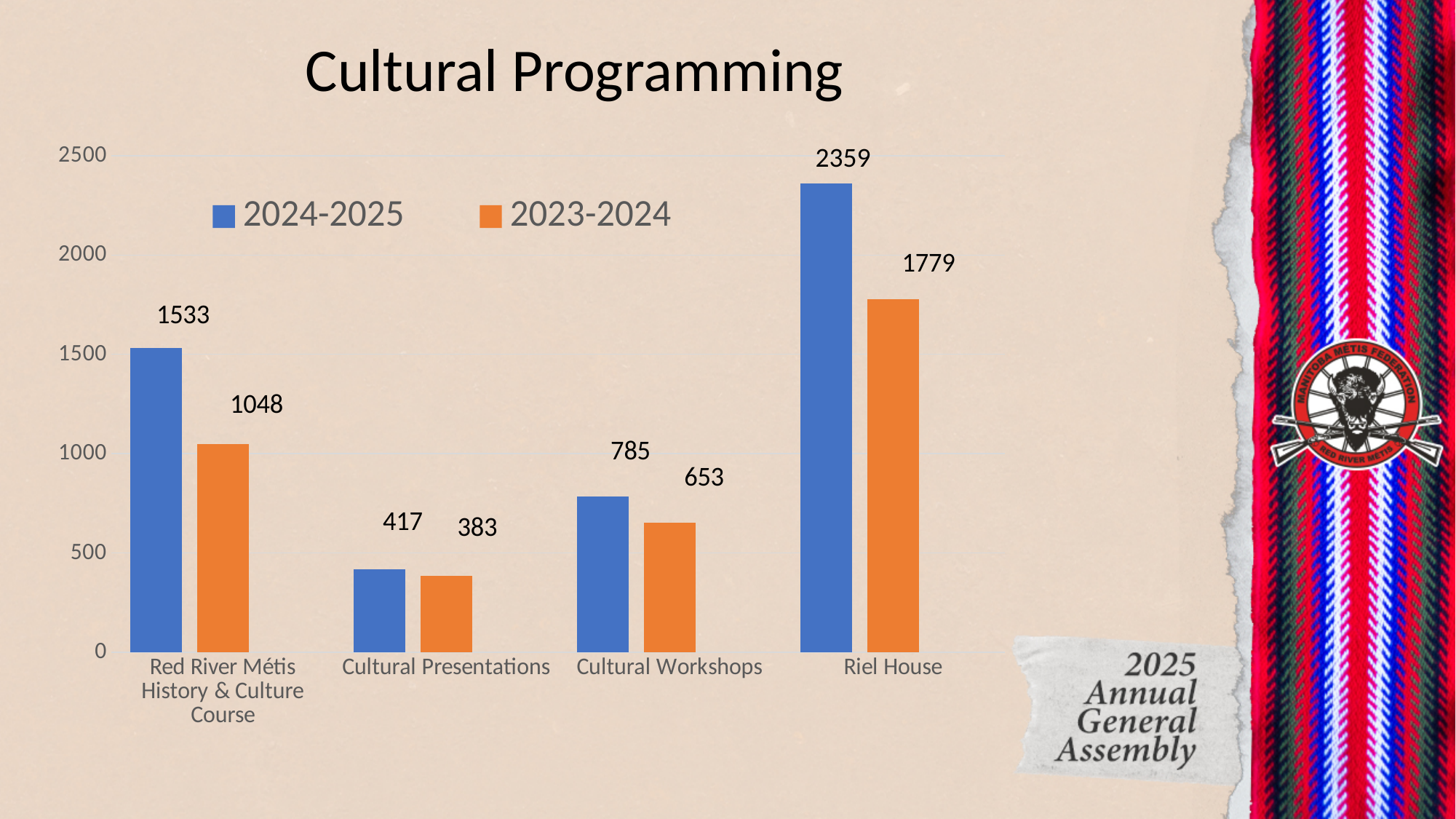
What is the 2023-2024 value for Cultural Presentations? 383 How many categories are shown on the x axis? 4 What kind of chart is shown on the slide? Bar chart What is the 2024-2025 value for Cultural Workshops? 785 How many series does the legend list? 2 Which category has the lowest 2023-2024 value? Cultural Presentations What is the 2024-2025 value for Riel House? 2359 What is the difference between the 2024-2025 and 2023-2024 values for Riel House? 580 What is the difference between the 2024-2025 and 2023-2024 values for the Red River Métis History & Culture Course? 485 What is the 2023-2024 value for the Red River Métis History & Culture Course? 1048 Which is larger for Cultural Workshops: the 2024-2025 value or the 2023-2024 value? 2024-2025 Which category has the highest 2024-2025 value? Riel House